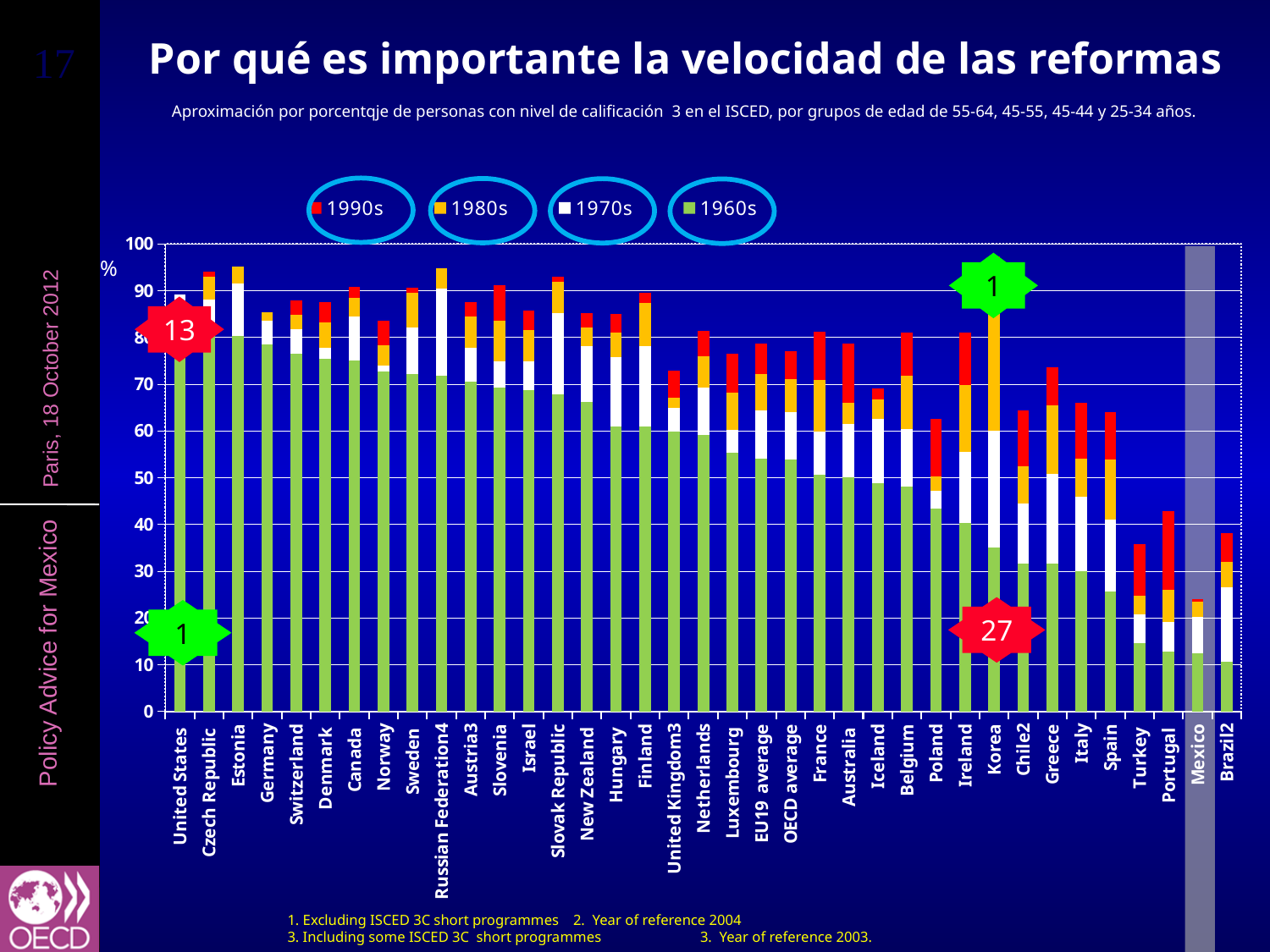
Which has the larger 1960s value, Estonia or Korea? Estonia Do the 1960s values generally rise or fall from left to right along the x axis? fall Is the 1960s value for Estonia greater or less than 70? greater How many series does the legend list? 4 Which colour represents the 1980s series in the legend? orange Is the total stacked value for Korea greater or less than 90? greater How many countries or groups are shown along the x axis? 37 Is the total stacked value for Turkey greater or less than 40? less Which country has the lowest total stacked value? Mexico What kind of chart is shown on the slide? bar chart